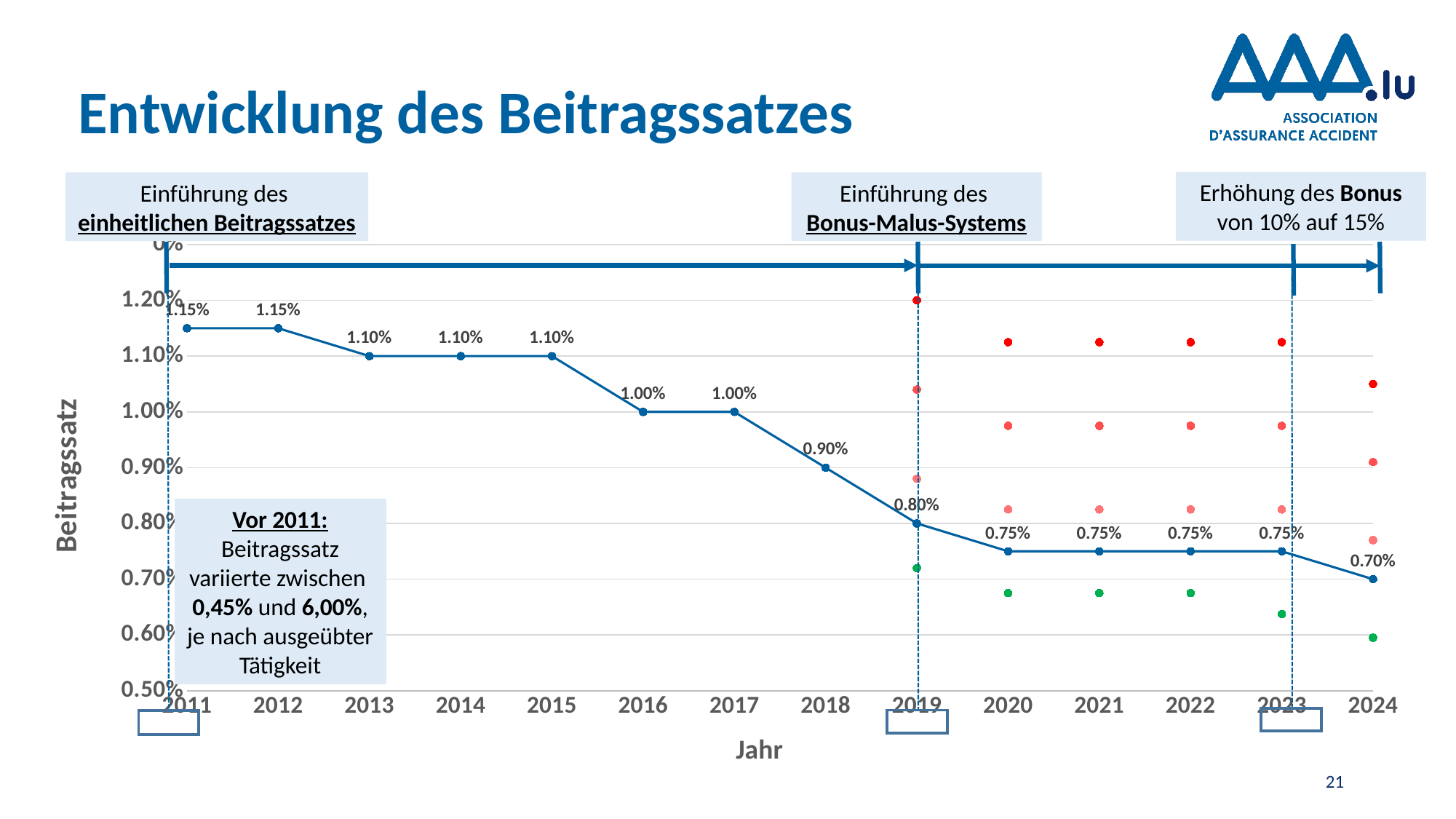
What is the title of the x axis? Jahr What is the Beitragssatz value for 2011? 1.15% Which is larger, the Beitragssatz in 2015 or in 2018? 2015 How many years are plotted on the x axis? 14 Does the Beitragssatz line rise or fall from 2011 to 2024? Fall What is the Beitragssatz value for 2024? 0.70% What is the Beitragssatz value for 2018? 0.90% What is the Beitragssatz value for 2019? 0.80% What is the difference between the Beitragssatz in 2015 and in 2016? 0.10% What kind of chart is shown on the slide? Line chart Which year has the lowest Beitragssatz on the line? 2024 What is the difference between the Beitragssatz in 2011 and in 2024? 0.45%